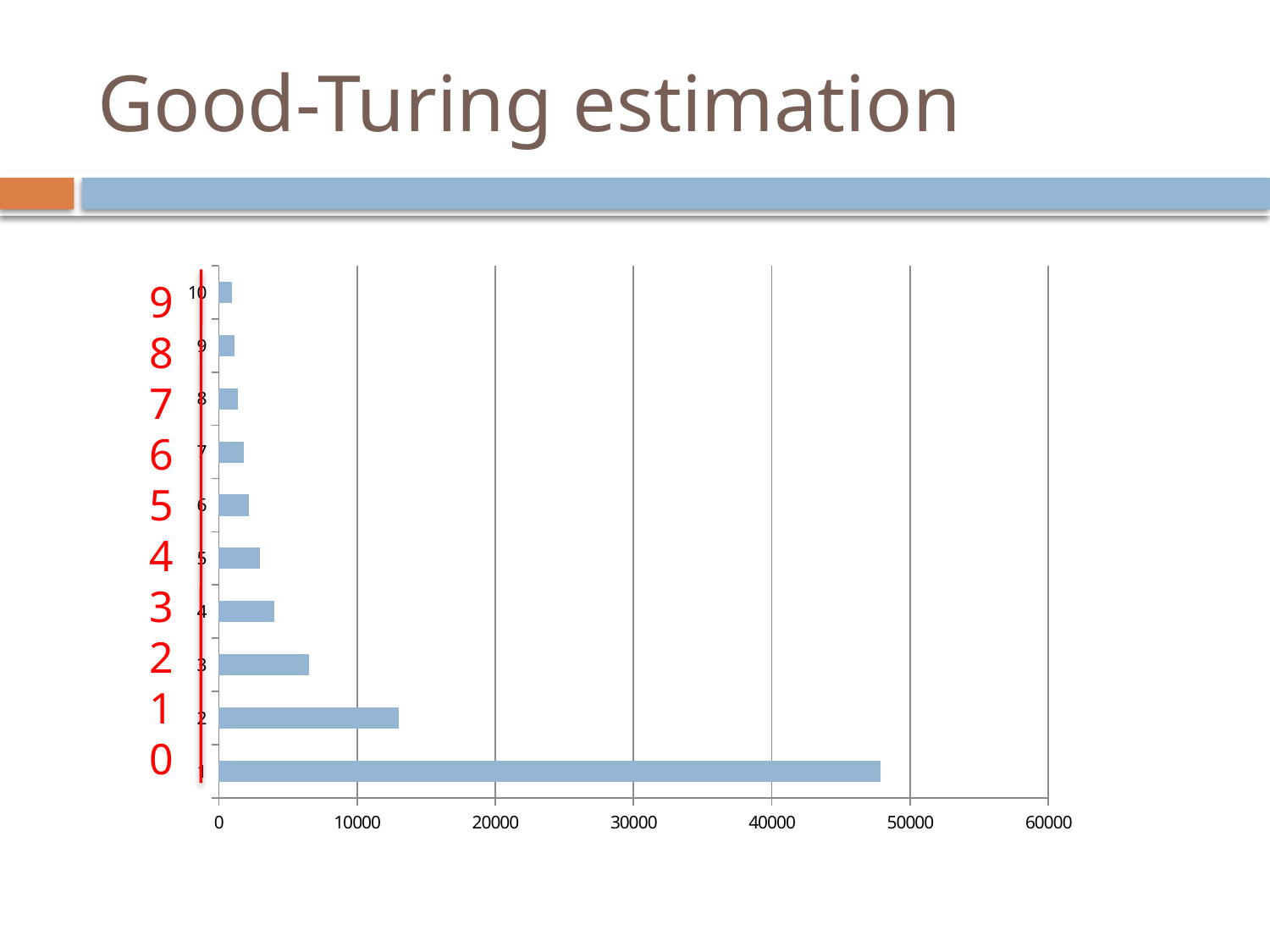
What is the title of the slide containing the chart? Good-Turing estimation Is the value for category 2 greater or less than 10000? greater Is the value for category 1 greater or less than 40000? greater Which category has the longest bar? 1 What kind of chart is shown on the slide? bar chart How many bars are plotted in the chart? 10 What is the highest tick value shown on the horizontal axis? 60000 Do the bar values increase or decrease as the category number goes from 1 to 10? decrease Is the value for category 1 greater or less than 50000? less Which category has the shortest bar? 10 Which is larger, the value for category 2 or the value for category 3? category 2